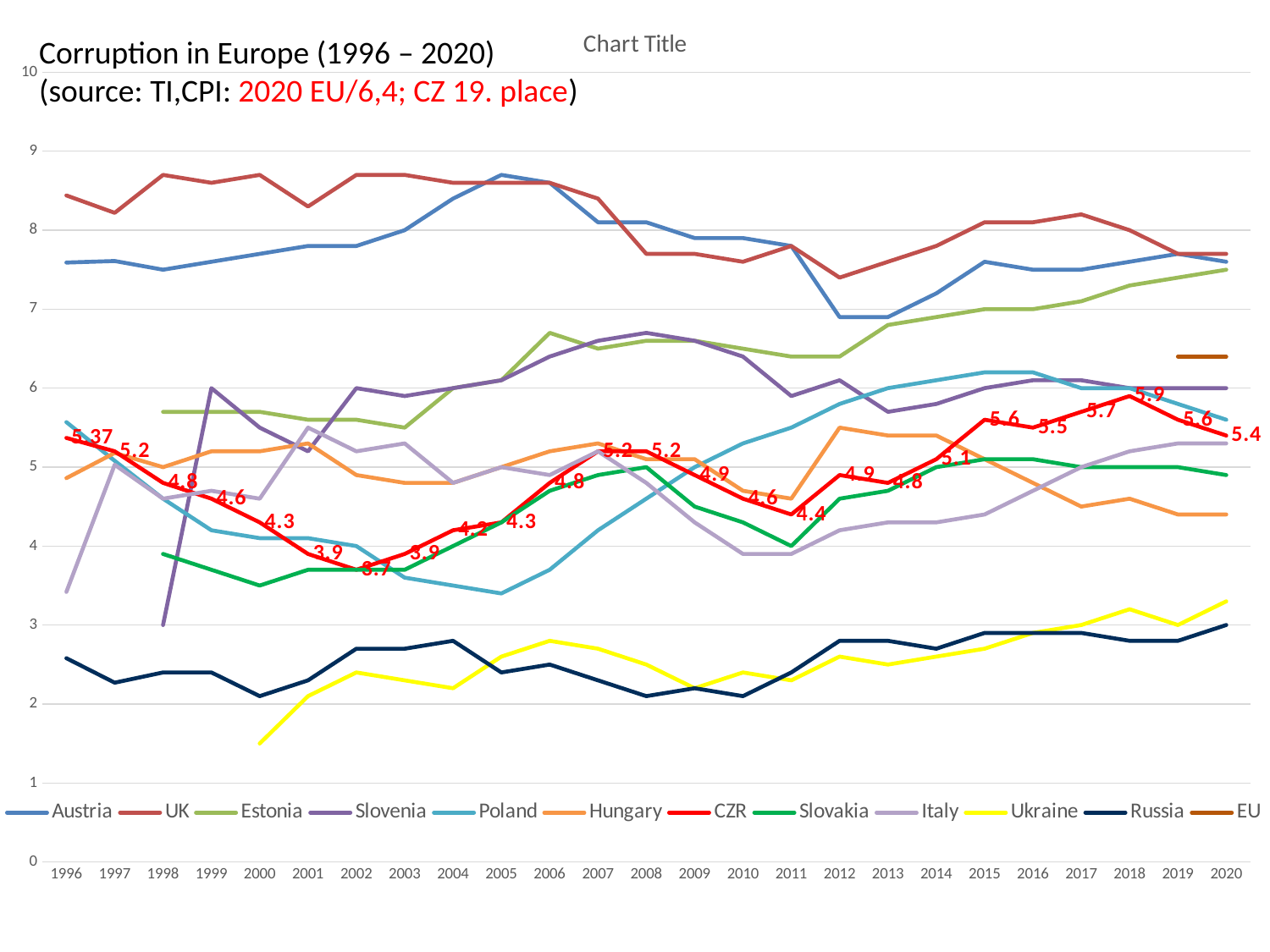
How many series does the legend list? 12 Does the CZR series rise or fall from 2011 to 2018? rise What kind of chart is shown on the slide? line chart What is the CZR value for 1996? 5.37 Which is larger, the CZR value for 2015 or for 2016? 2015 What is the CZR value for 2002? 3.7 Is the value for Ukraine in 2000 greater or less than 2? less How many years are shown along the x axis? 25 In which year does the CZR series reach its lowest labelled value? 2002 What is the difference between the CZR values for 2018 and 2002? 2.2 In which year does the CZR series reach its highest labelled value? 2018 What is the CZR value for 2020? 5.4